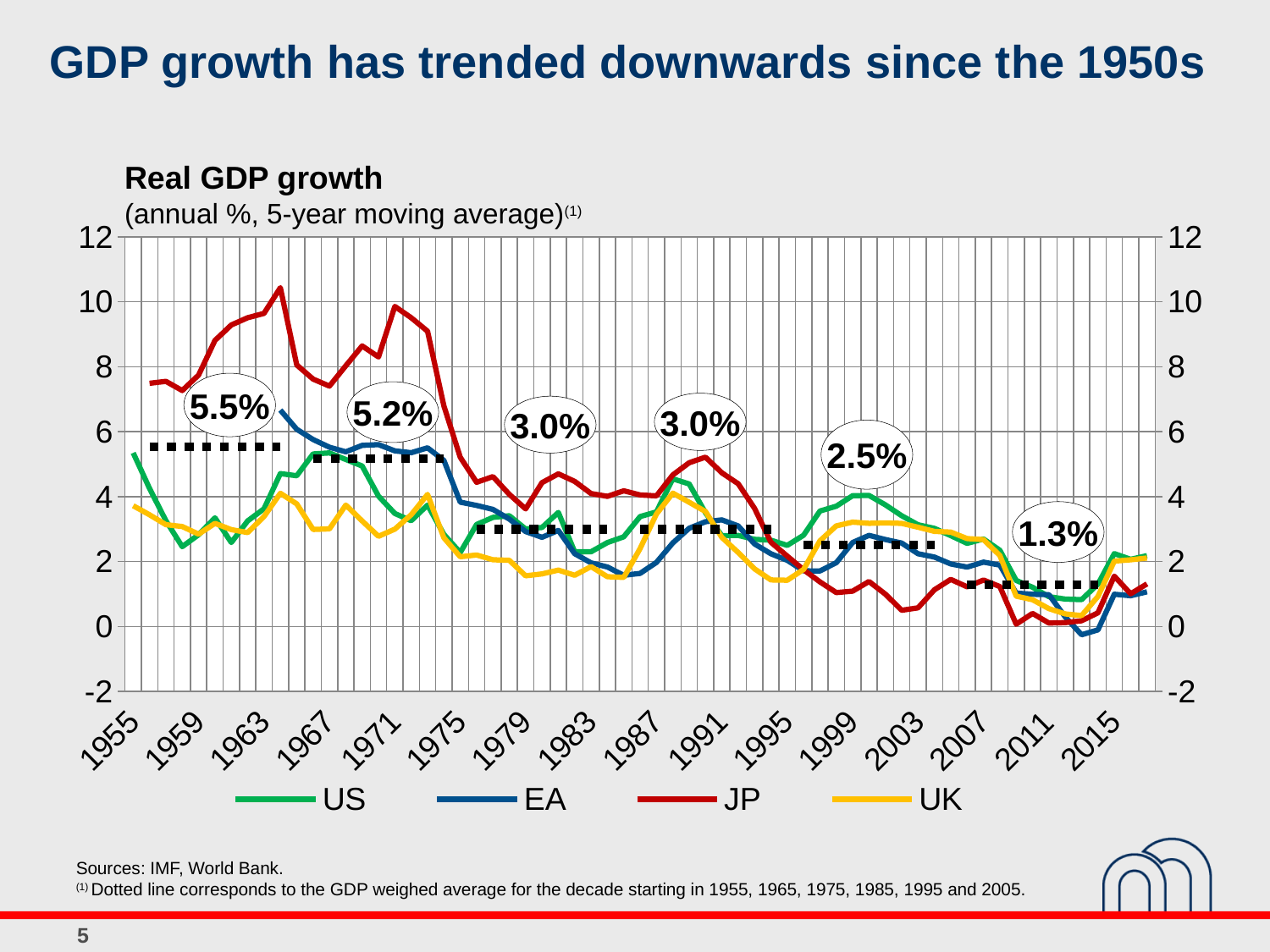
What is the GDP-weighted average growth shown by the dotted line for the decade starting in 1955? 5.5% What is the title of the chart? Real GDP growth How many series does the legend list? 4 Overall, do the growth rates rise or fall from 1955 to 2015? fall Which series are listed in the legend? US, EA, JP, UK What kind of chart is shown on the slide? line chart Which decade has the highest dotted-line average growth? the decade starting in 1955 (5.5%) Which series has the highest growth rate around 1965? JP What is the GDP-weighted average growth shown by the dotted line for the decade starting in 1995? 2.5% What is the difference between the dotted-line average for the decade starting in 1955 and the one for the decade starting in 2005? 4.2 percentage points What is the GDP-weighted average growth shown by the dotted line for the decade starting in 2005? 1.3%